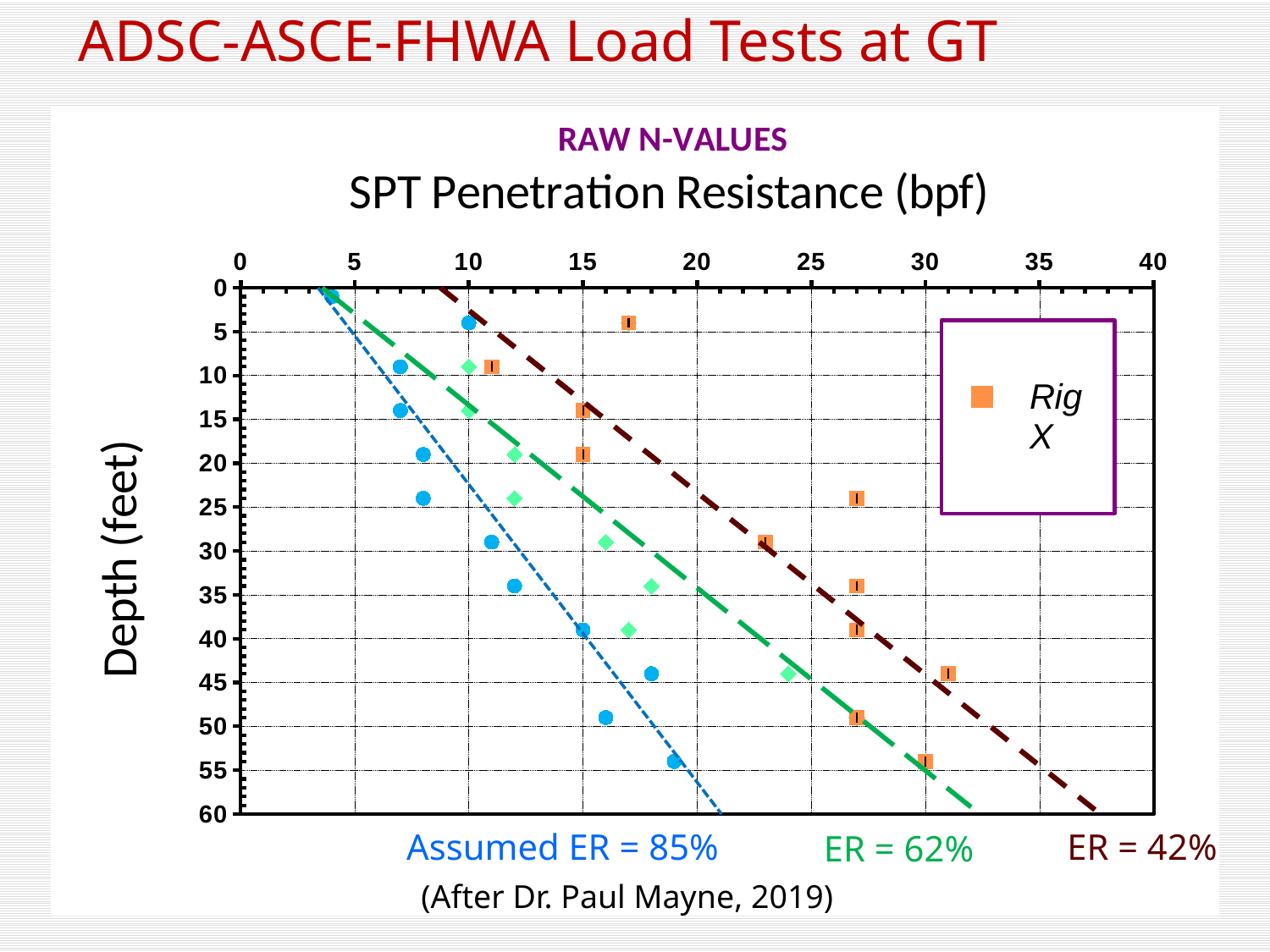
What kind of chart is shown on the slide? scatter chart How many Rig X (orange square) data points are plotted on the chart? 11 Which series has the lowest N-values overall across the depths shown: the blue circles, green diamonds, or Rig X orange squares? blue circles Is the Rig X N-value at a depth of about 44 feet greater or less than 25 bpf? greater At a depth of about 29 feet, which series has the larger N-value: Rig X (orange squares) or the blue circles? Rig X Which series has the highest N-values overall across the depths shown? Rig X Do the Rig X N-values generally increase or decrease as depth increases? increase Is the green diamond N-value at a depth of about 44 feet greater or less than 20 bpf? greater What is the only series named in the chart legend? Rig X Which energy ratio (ER) label is associated with the dark red dashed trend line? ER = 42% Is the blue circle N-value at a depth of about 24 feet greater or less than 10 bpf? less